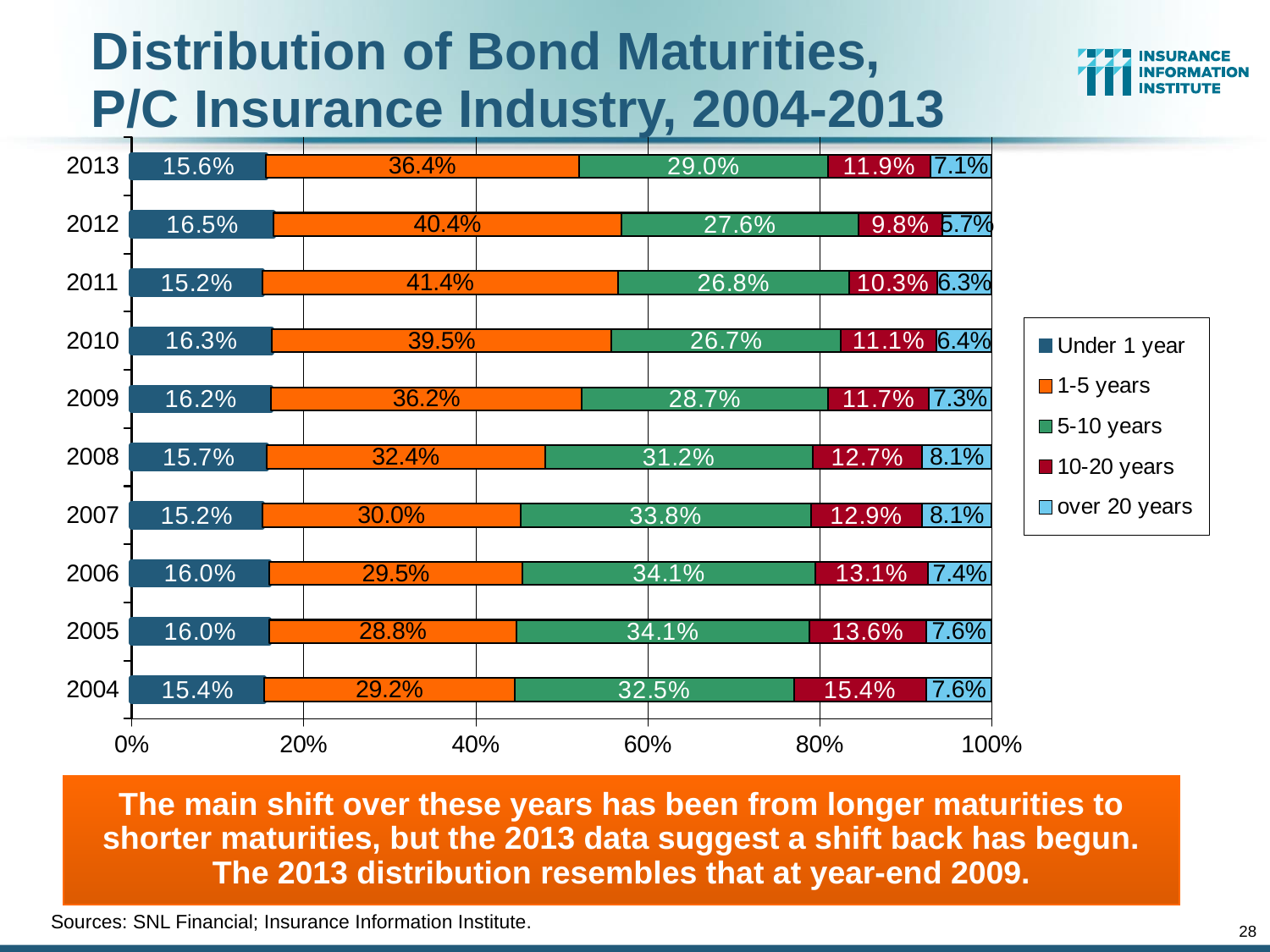
Which year had a larger 5-10 years share, 2008 or 2013? 2008 In which year was the over 20 years share the lowest? 2012 In which year was the 1-5 years share the highest? 2011 How many years are shown on the chart? 10 What share of bonds had a maturity of 1-5 years in 2013? 36.4% What was the 5-10 years share in 2007? 33.8% What kind of chart is shown on the slide? Stacked bar chart By how many percentage points did the 1-5 years share in 2013 exceed that in 2004? 7.2 percentage points Which maturity category is shown in orange? 1-5 years Did the 10-20 years share rise or fall from 2004 to 2012? Fall What share of bonds had a maturity of 10-20 years in 2004? 15.4% How many maturity categories does the legend list? 5